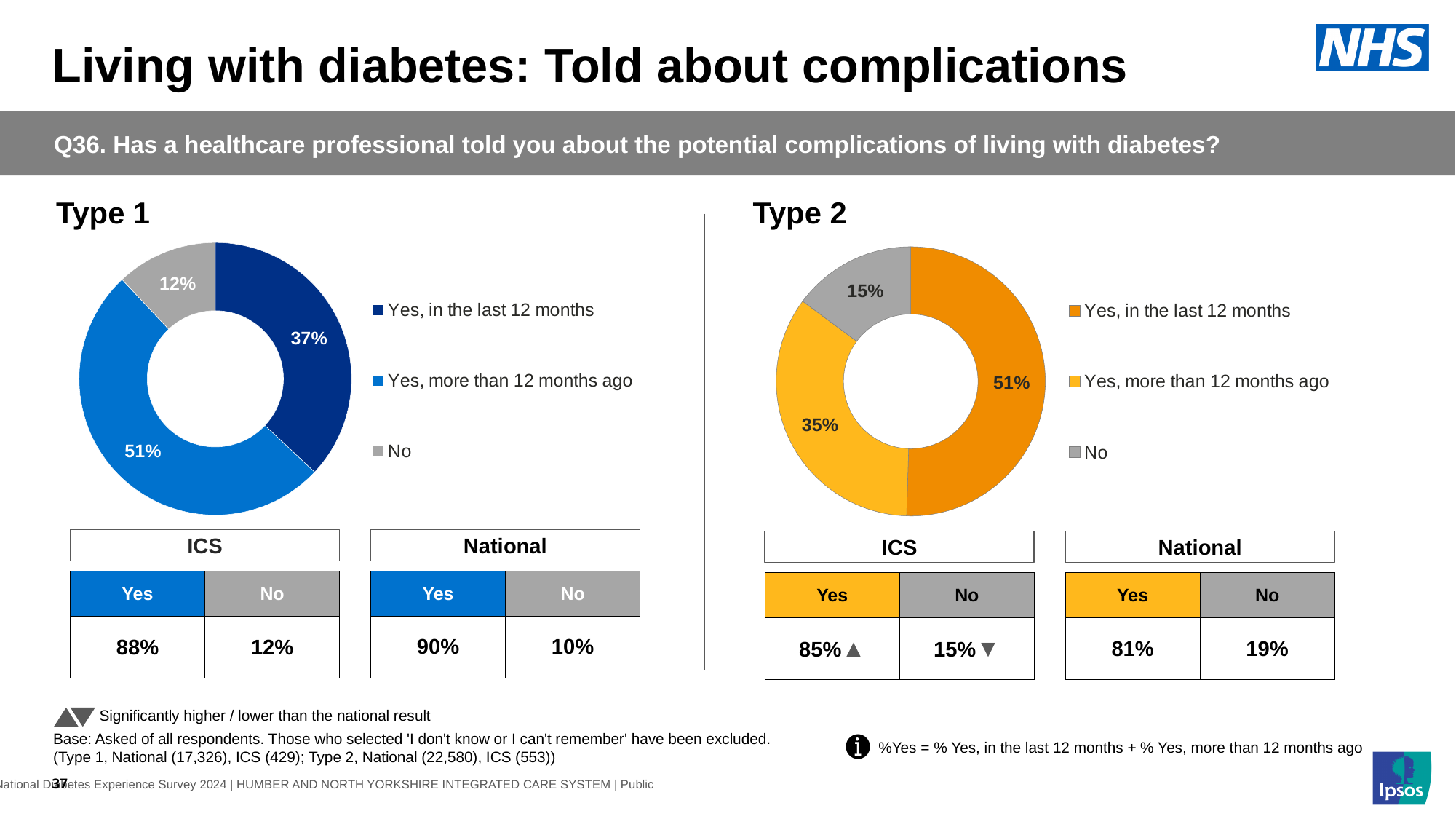
In the Type 1 chart, what percentage of respondents said 'Yes, more than 12 months ago'? 51% How many categories does the Type 1 chart show? 3 What kind of chart is used for Type 2? Doughnut chart Which is larger: the 'Yes, in the last 12 months' share in the Type 1 chart or in the Type 2 chart? Type 2 In the Type 2 chart, what is the difference between the 'Yes, in the last 12 months' and 'Yes, more than 12 months ago' shares? 16% In the Type 1 chart, which response has the largest share? Yes, more than 12 months ago In the Type 1 chart, what percentage of respondents said 'Yes, in the last 12 months'? 37% What colour represents 'No' in the Type 1 chart? Grey In the Type 2 chart, which response has the smallest share? No In the Type 1 chart, what is the difference between the 'Yes, more than 12 months ago' and 'No' shares? 39% In the Type 2 chart, what percentage of respondents said 'No'? 15% In the Type 2 chart, what percentage of respondents said 'Yes, in the last 12 months'? 51%